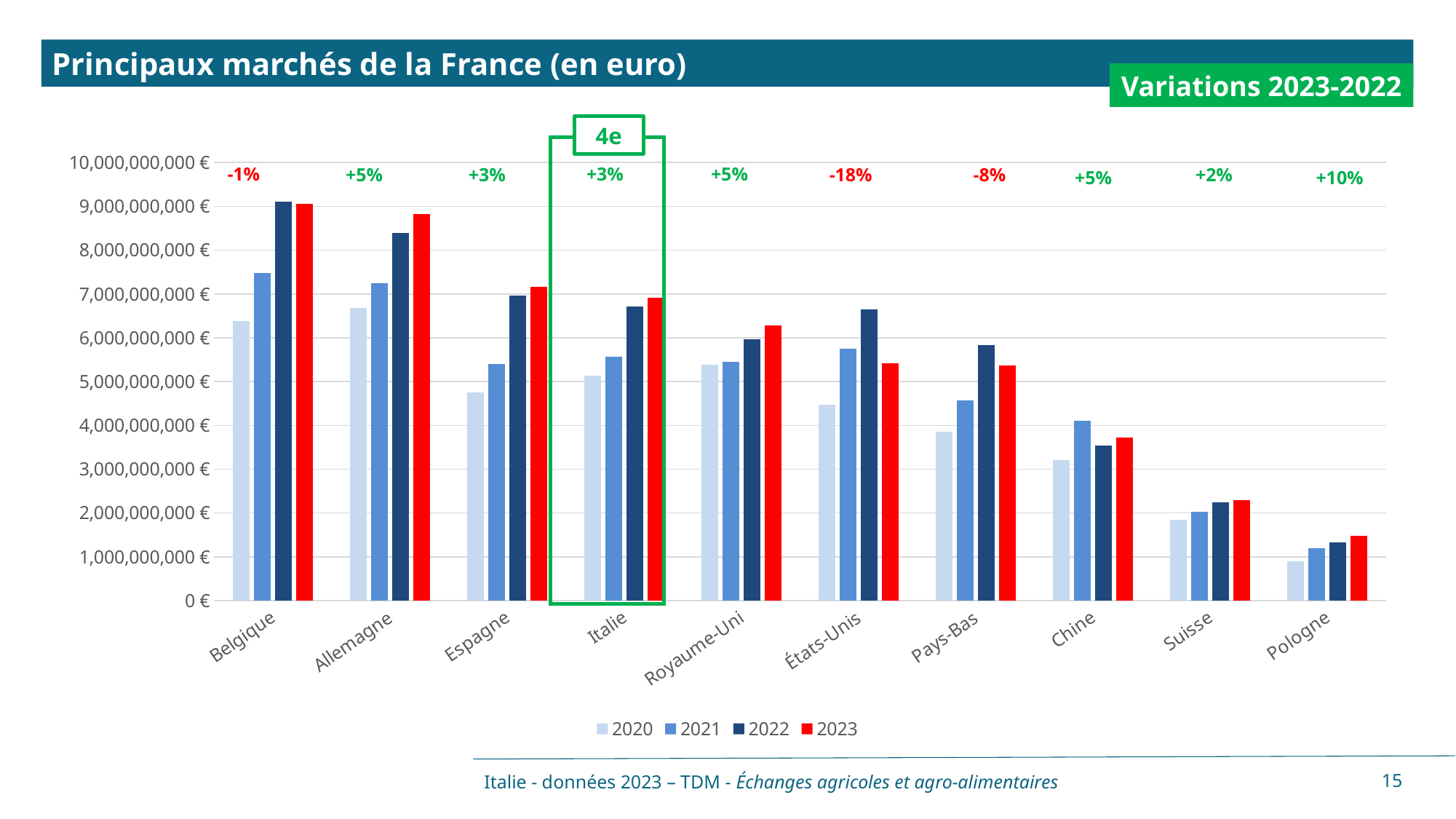
What kind of chart is shown on the slide? bar chart Is the 2023 value for Suisse greater or less than 2,000,000,000 €? greater How many countries are shown on the x axis of the chart? 10 Which country shows the largest negative 2023-2022 variation? États-Unis Which country has the lowest 2023 value in the chart? Pologne Which is larger, the 2023 value for Royaume-Uni or the 2023 value for États-Unis? Royaume-Uni What rank label is shown in the green box above Italie? 4e Is the 2023 value for Chine greater or less than 4,000,000,000 €? less How many series does the chart legend list? 4 What is the 2023-2022 variation shown for Pologne? +10% What is the 2023-2022 variation shown for États-Unis? -18% For Pays-Bas, did the value rise or fall from 2022 to 2023? fall